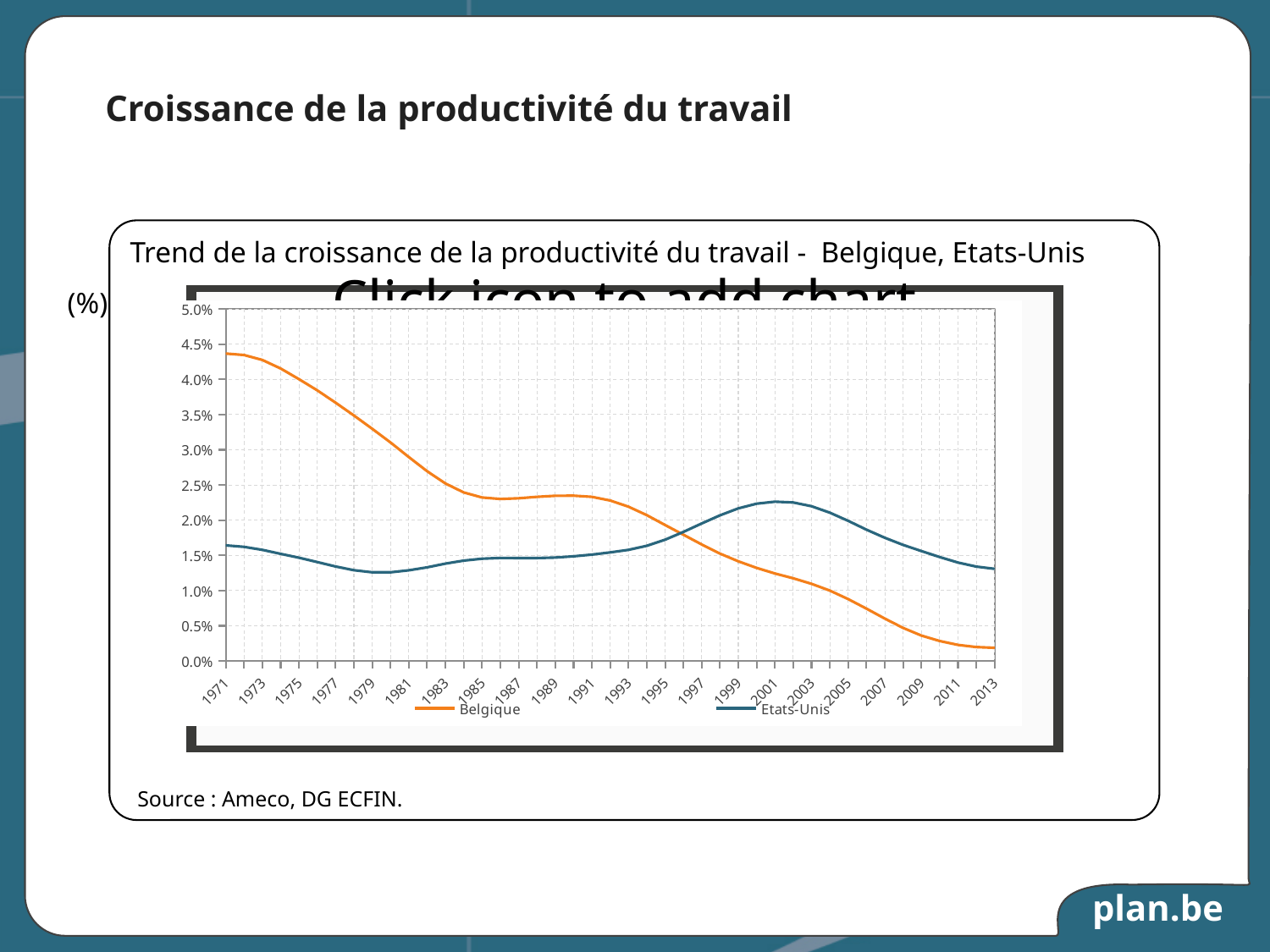
Does the Belgique line rise or fall overall from 1971 to 2013? Fall What is the title of the chart? Trend de la croissance de la productivité du travail - Belgique, Etats-Unis Is the value for Belgique in 1971 greater or less than 4.0%? greater In 1971, which series has the higher value, Belgique or Etats-Unis? Belgique Is the value for Etats-Unis in 1979 greater or less than 1.5%? less Is the value for Belgique in 2013 greater or less than 0.5%? less Which two series are listed in the chart legend? Belgique and Etats-Unis In 2013, which series has the higher value, Belgique or Etats-Unis? Etats-Unis How many series does the legend list? 2 In which year does the Belgique line reach its highest value? 1971 What kind of chart is shown on the slide? Line chart